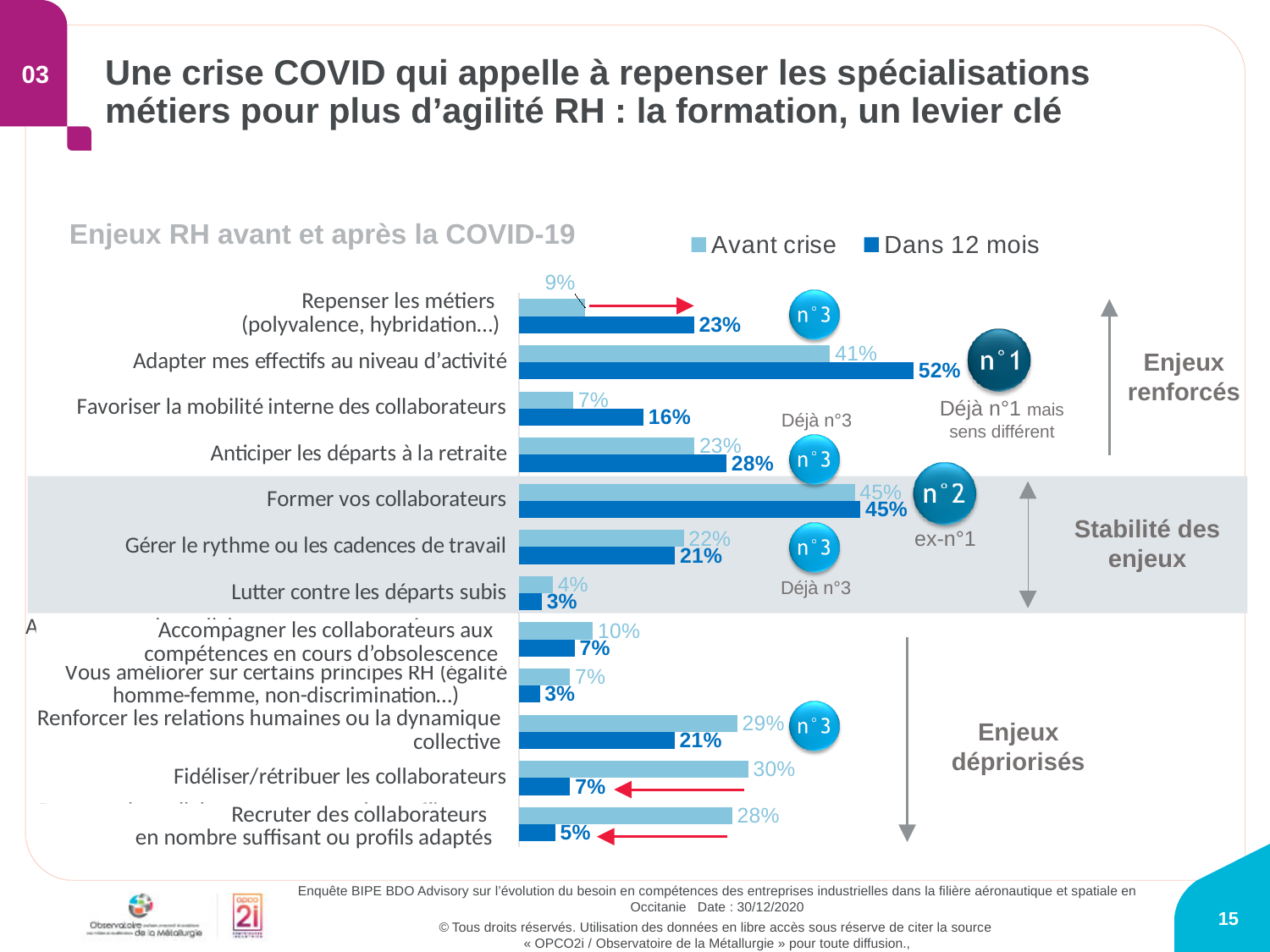
Which category has the highest 'Dans 12 mois' value? Adapter mes effectifs au niveau d'activité What type of chart is shown on the slide? Bar chart What is the 'Avant crise' value for 'Former vos collaborateurs'? 45% What is the title of the chart? Enjeux RH avant et après la COVID-19 Which category has the lowest 'Avant crise' value? Lutter contre les départs subis For 'Favoriser la mobilité interne des collaborateurs', which is larger: the 'Avant crise' value or the 'Dans 12 mois' value? Dans 12 mois What is the 'Dans 12 mois' value for 'Fidéliser/rétribuer les collaborateurs'? 7% How many categories are shown in the chart? 12 What is the 'Avant crise' value for 'Repenser les métiers (polyvalence, hybridation…)'? 9% What is the difference between the 'Avant crise' and 'Dans 12 mois' values for 'Recruter des collaborateurs en nombre suffisant ou profils adaptés'? 23 percentage points What is the 'Dans 12 mois' value for 'Adapter mes effectifs au niveau d'activité'? 52% How many series does the legend list? 2